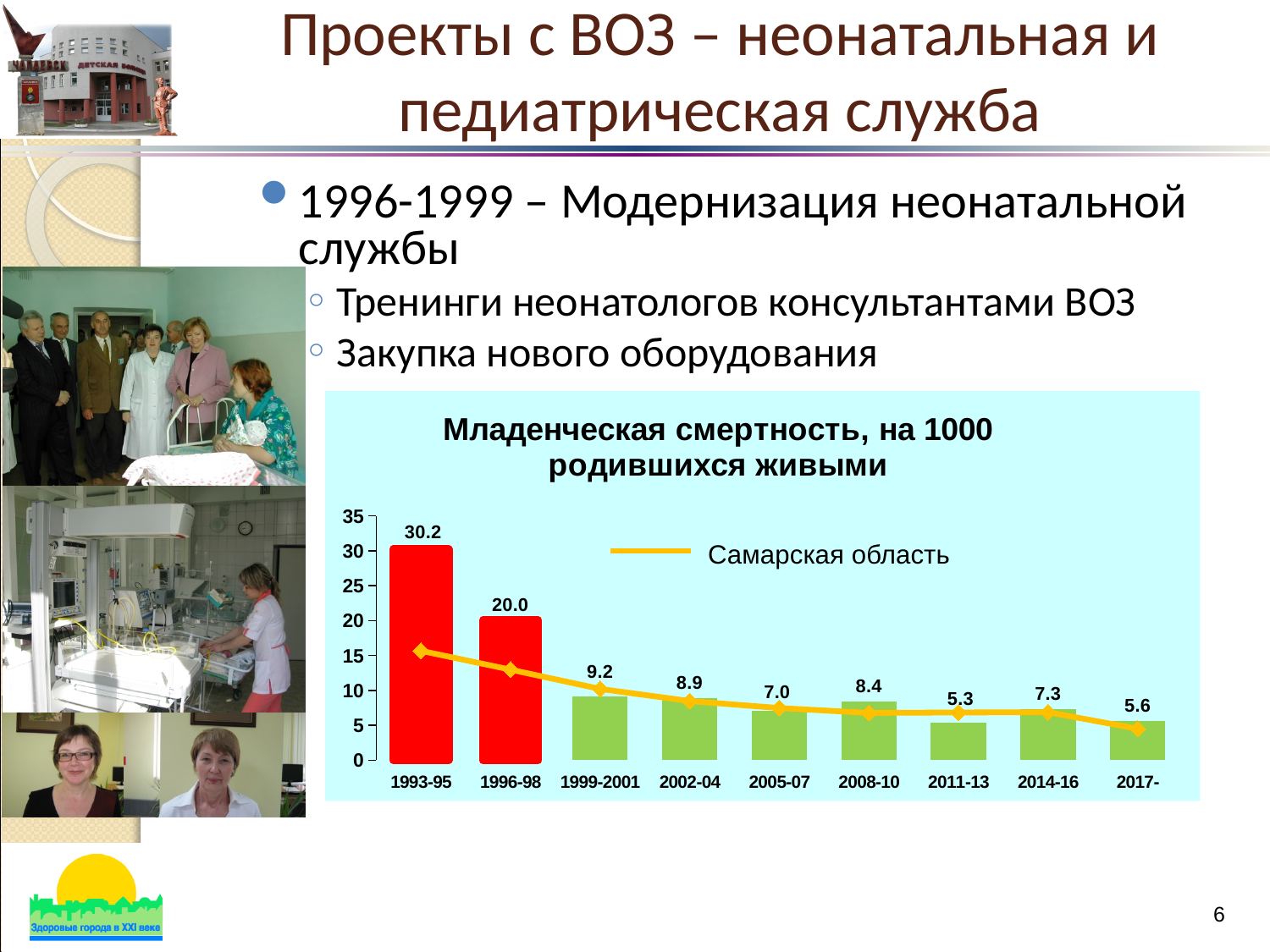
What is the value shown for 2017-? 5.6 Which period has the highest bar? 1993-95 What kind of chart is this? bar chart with a line How many periods are shown on the x axis? 9 Is the Самарская область line value for 1996-98 greater or less than 15? less Do the bar values generally rise or fall from 1993-95 to 2017-? fall How many series does the legend list? 1 What is the infant mortality value for 1993-95? 30.2 What is the value shown for 2008-10? 8.4 What is the difference between the values for 1993-95 and 1996-98? 10.2 Which period has the lowest bar? 2011-13 Which is larger, the value for 2008-10 or the value for 2014-16? 2008-10